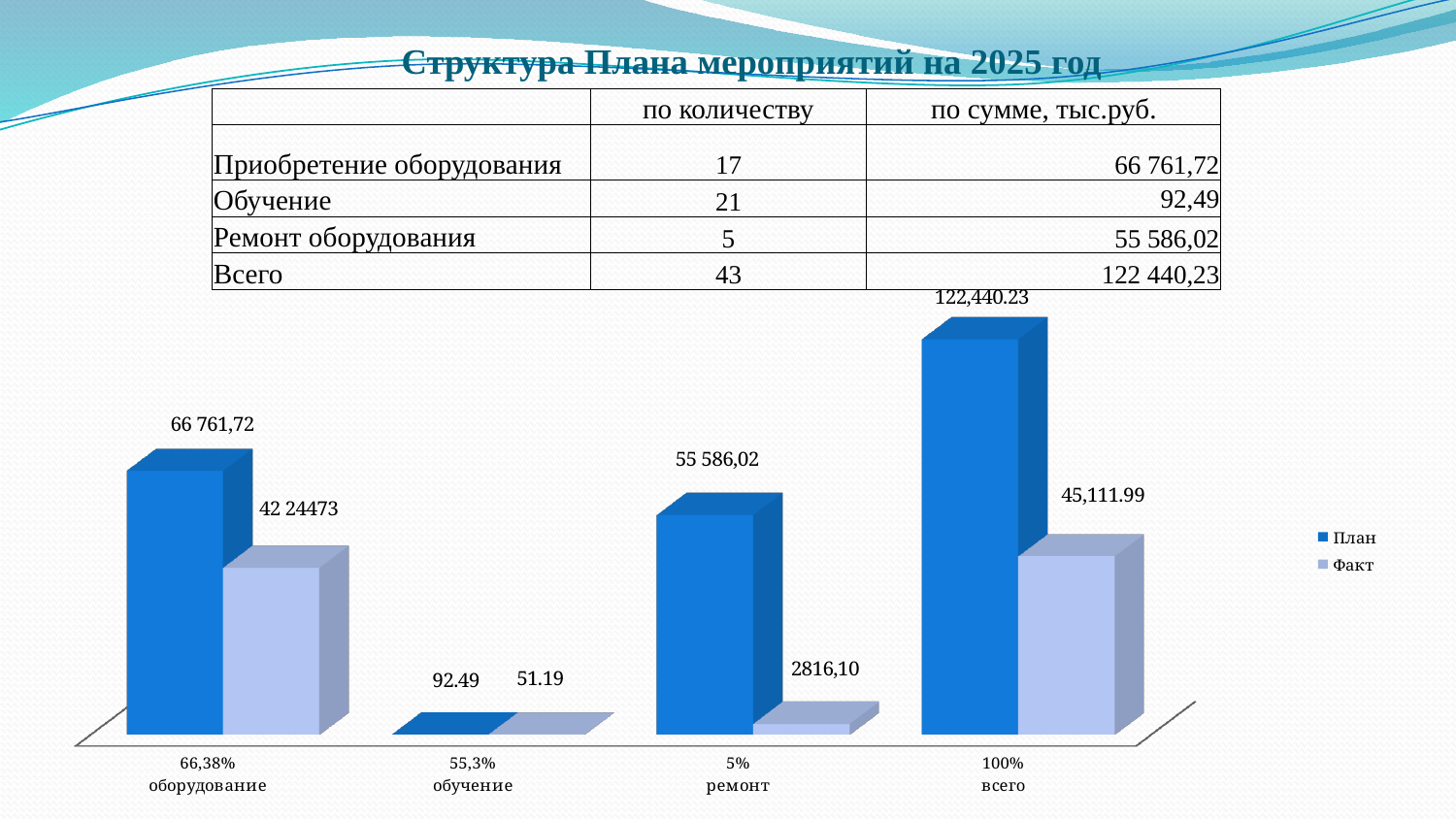
Which is larger, the План value for оборудование or the План value for ремонт? оборудование How many categories are shown along the x axis of the chart? 4 What is the План value for ремонт? 55 586,02 What is the План value for оборудование? 66 761,72 What is the Факт value for ремонт? 2816,10 Which category has the highest План value? всего What is the Факт value for обучение? 51.19 How many series does the chart legend list? 2 Which category has the lowest Факт value? обучение What is the difference between the План and Факт values for обучение? 41.30 What is the Факт value for всего? 45,111.99 What kind of chart is shown on the slide? bar chart